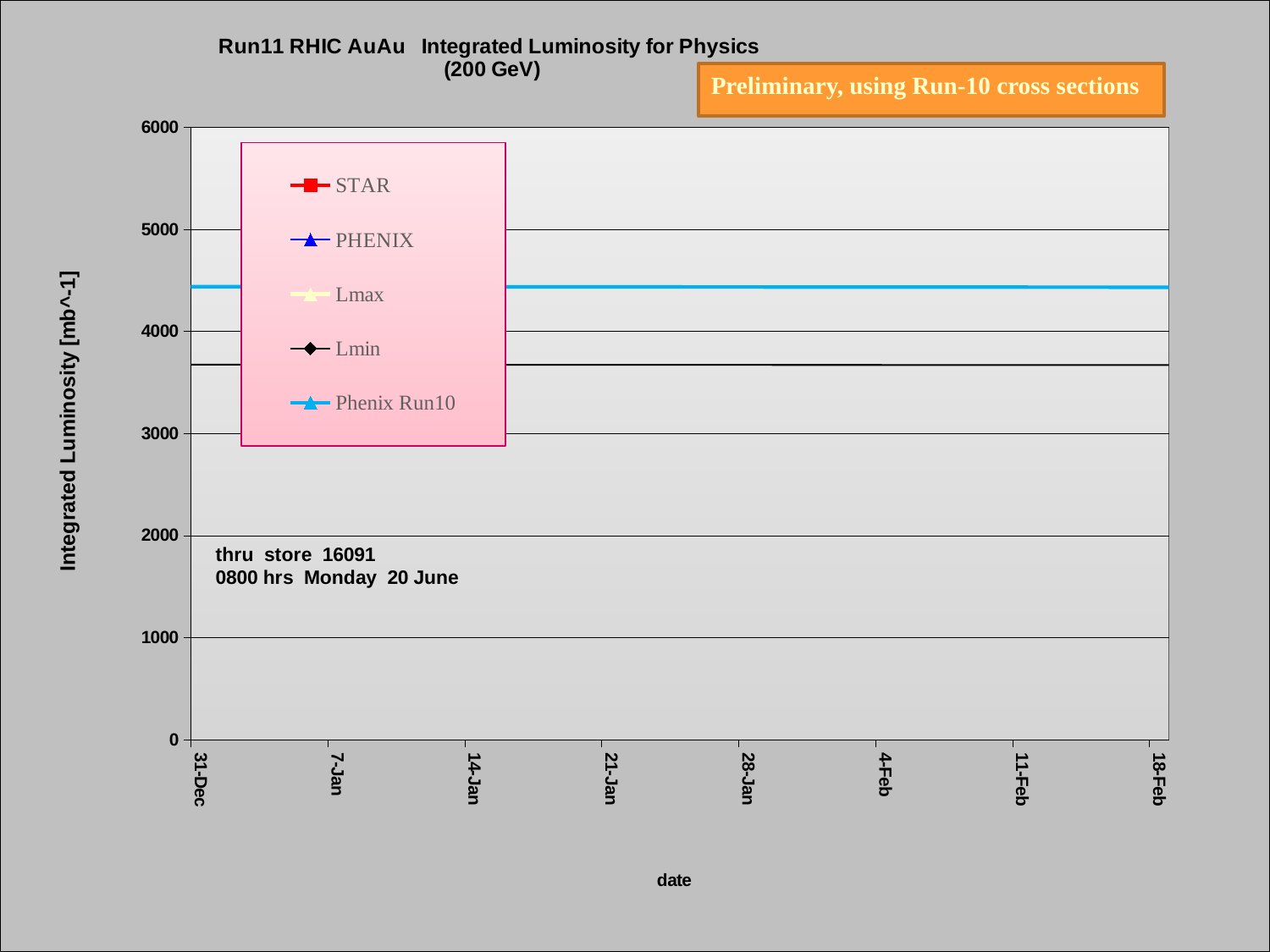
Is the value of the Lmin line greater or less than 3000? greater What is the label of the y axis? Integrated Luminosity [mb^-1] What kind of chart is shown on the slide? line chart Is the value of the Lmin line greater or less than 4000? less What is the first date label on the x axis? 31-Dec What is the last date label on the x axis? 18-Feb How many series does the legend list? 5 Which line is higher on the chart, Phenix Run10 or Lmin? Phenix Run10 Does the Phenix Run10 line rise, fall, or stay flat across the dates on the x axis? stay flat Is the value of the Phenix Run10 line greater or less than 4000? greater How many date labels are shown along the x axis? 8 What is the title of the chart? Run11 RHIC AuAu Integrated Luminosity for Physics (200 GeV)